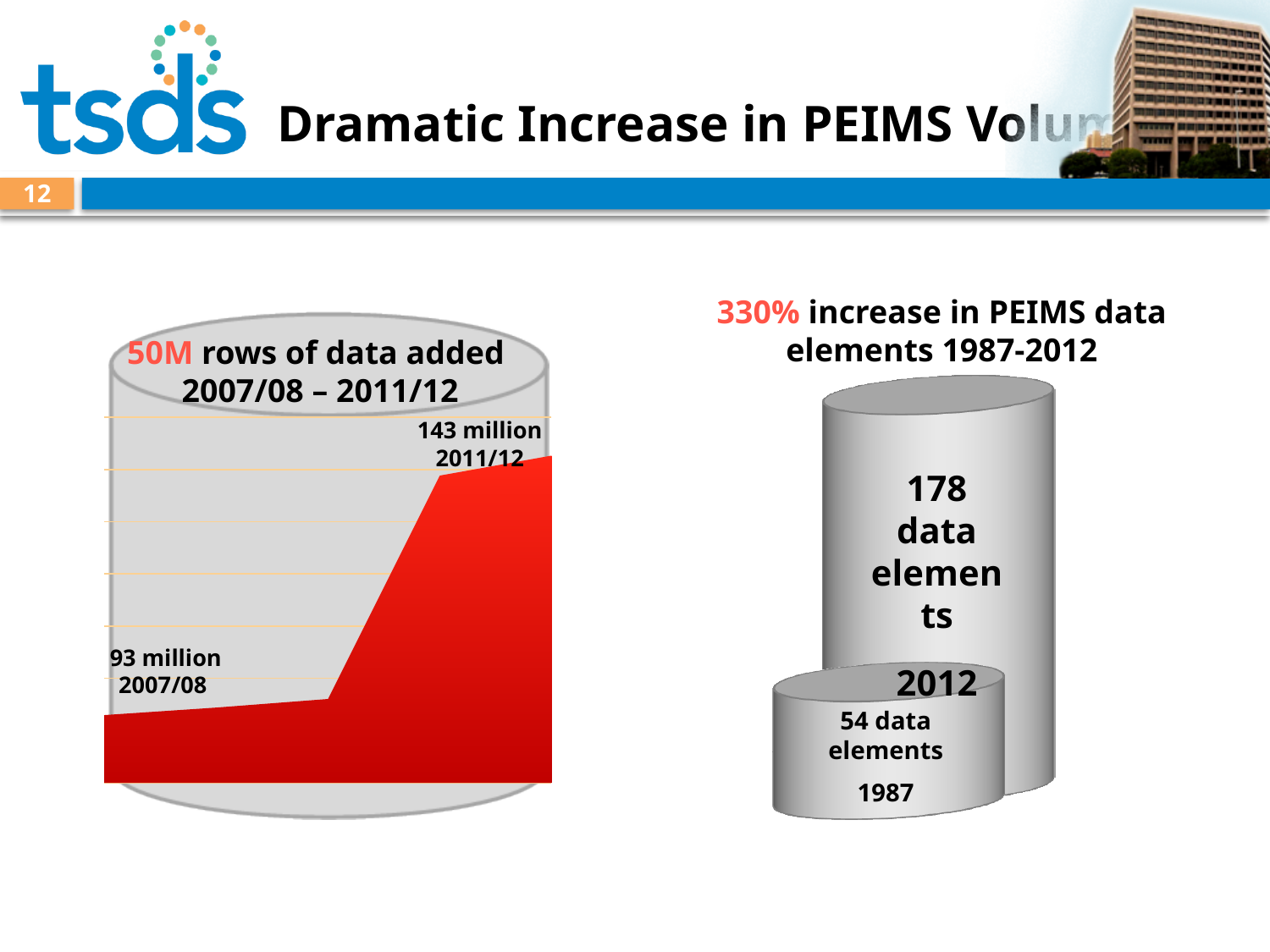
In the left chart, do the values rise or fall from 2007/08 to 2011/12? rise In the left chart, how many rows of data are shown for 2011/12? 143 million In the right chart, which year has more data elements, 1987 or 2012? 2012 According to the right chart's title, what is the percentage increase in PEIMS data elements from 1987 to 2012? 330% In the left chart, which period has the larger value, 2007/08 or 2011/12? 2011/12 What is the title of the left chart? 50M rows of data added 2007/08 – 2011/12 In the left chart, what is the difference between the 2011/12 value and the 2007/08 value? 50 million In the right chart, how many data elements are shown for 2012? 178 data elements In the right chart, how many data elements are shown for 1987? 54 data elements What kind of chart is the left chart? area chart In the right chart, what is the difference in data elements between 2012 and 1987? 124 In the left chart, how many rows of data are shown for 2007/08? 93 million